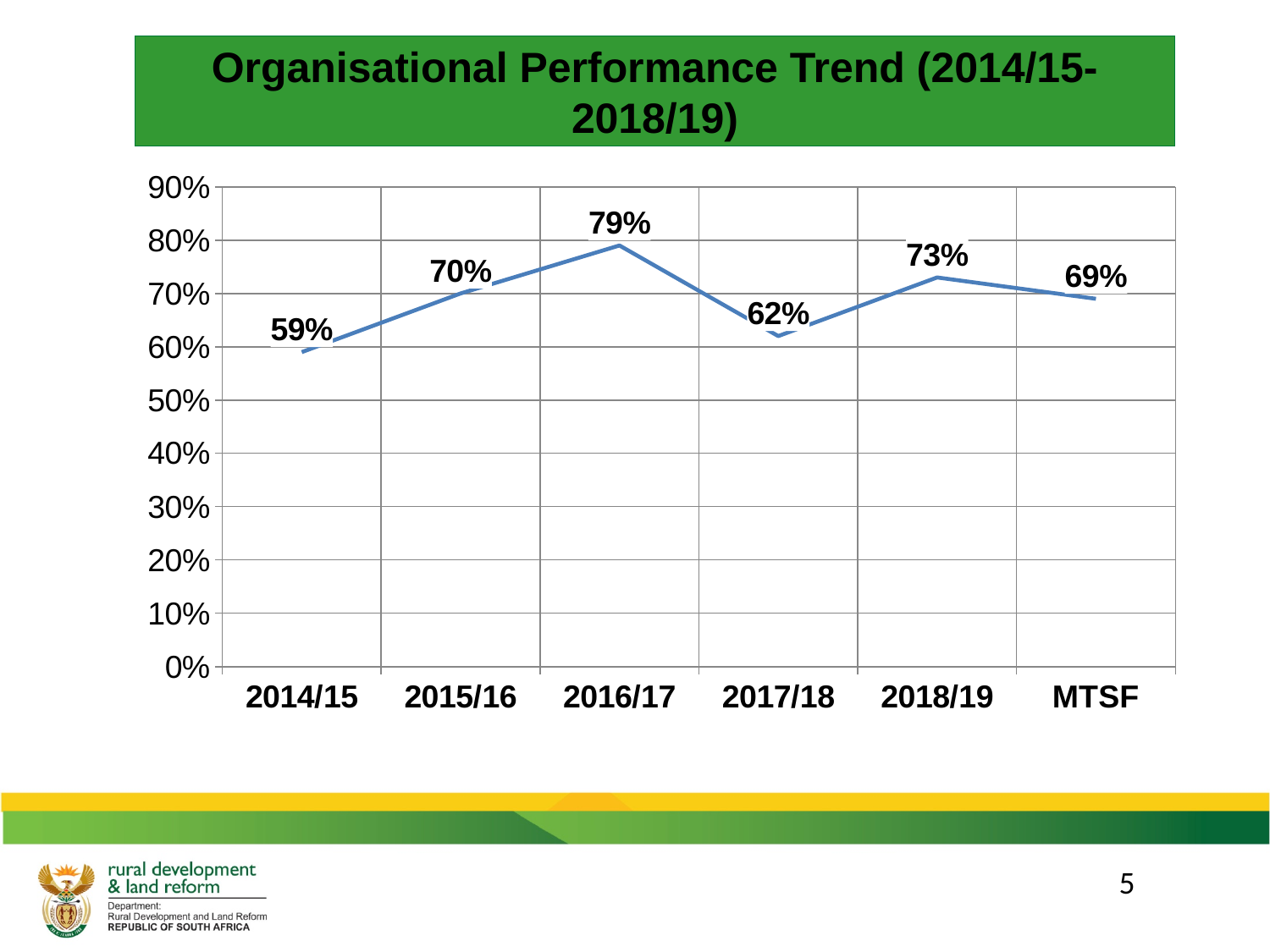
How many categories are shown on the x axis? 6 What is the difference between the values for 2016/17 and 2017/18? 17% What is the value for 2016/17? 79% Do the values rise or fall from 2014/15 to 2016/17? rise What is the value for 2014/15? 59% What is the value for MTSF? 69% Which category has the lowest value? 2014/15 What kind of chart is shown on the slide? line chart Which category has the highest value? 2016/17 Is the value for 2017/18 greater or less than 70%? less Which is larger, the value for 2018/19 or the value for MTSF? 2018/19 What is the title of the chart? Organisational Performance Trend (2014/15-2018/19)